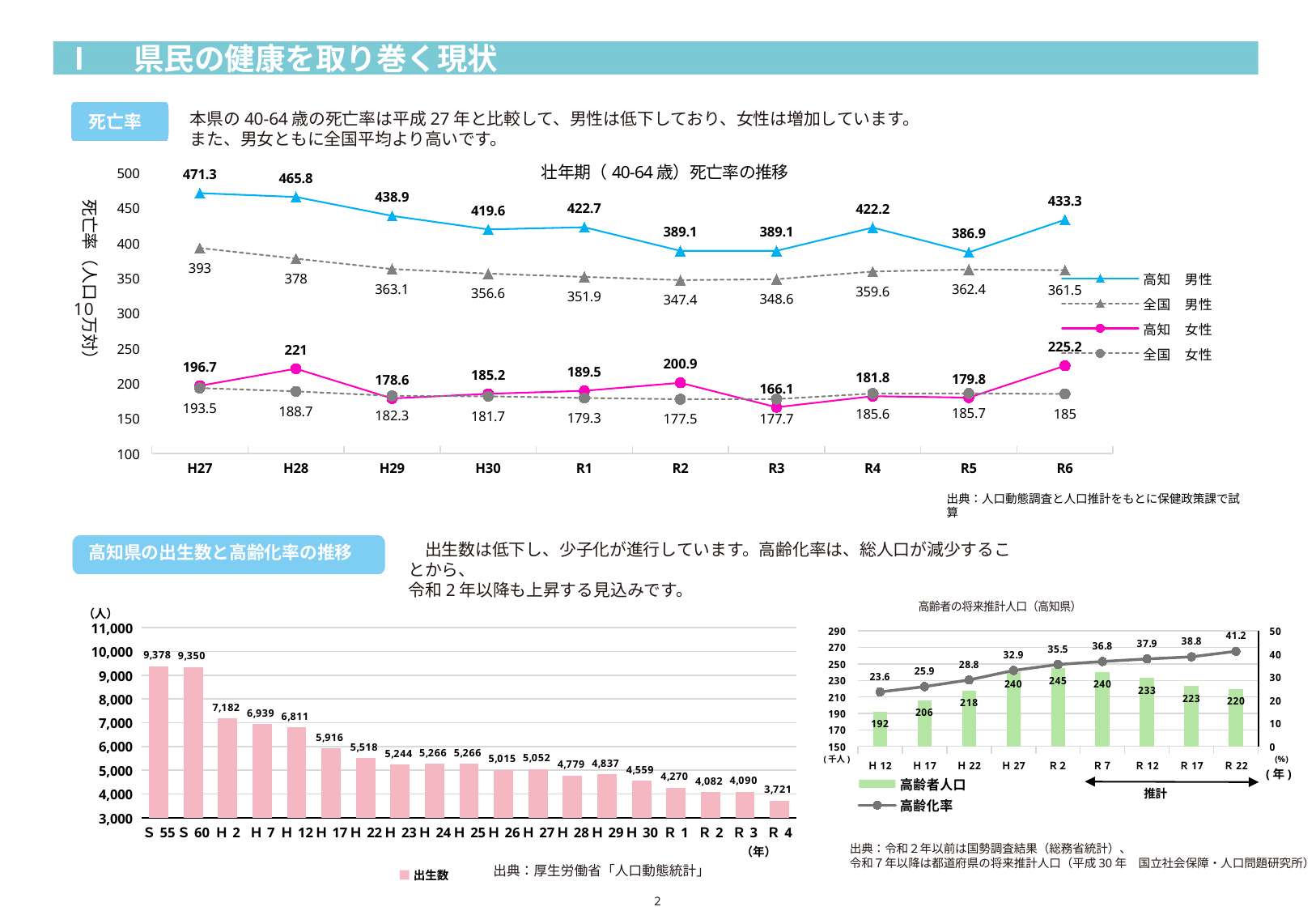
In the chart titled 壮年期（40-64歳）死亡率の推移, what is the difference between the 高知 男性 and 全国 男性 values in R6? 71.8 In the chart titled 壮年期（40-64歳）死亡率の推移, what is the value for 全国 女性 in R2? 177.5 In the chart titled 壮年期（40-64歳）死亡率の推移, how many series does the legend list? 4 In the bottom-left chart of 出生数, which year has the highest value? S 55 In the bottom-left chart of 出生数, how many years are plotted? 19 In the chart titled 高齢者の将来推計人口（高知県）, what is the difference between the 高齢者人口 values for R 2 and H 12? 53 In the chart titled 壮年期（40-64歳）死亡率の推移, which is larger in R4: 高知 女性 or 全国 女性? 全国 女性 What kind of chart is the bottom-left chart of 出生数? Bar chart In the chart titled 高齢者の将来推計人口（高知県）, what is the 高齢化率 value for R 22? 41.2 In the chart titled 壮年期（40-64歳）死亡率の推移, in which year is the 高知 女性 value lowest? R3 In the chart titled 壮年期（40-64歳）死亡率の推移, what is the value for 高知 男性 in H27? 471.3 In the bottom-left chart of 出生数, what is the value for H 22? 5,518